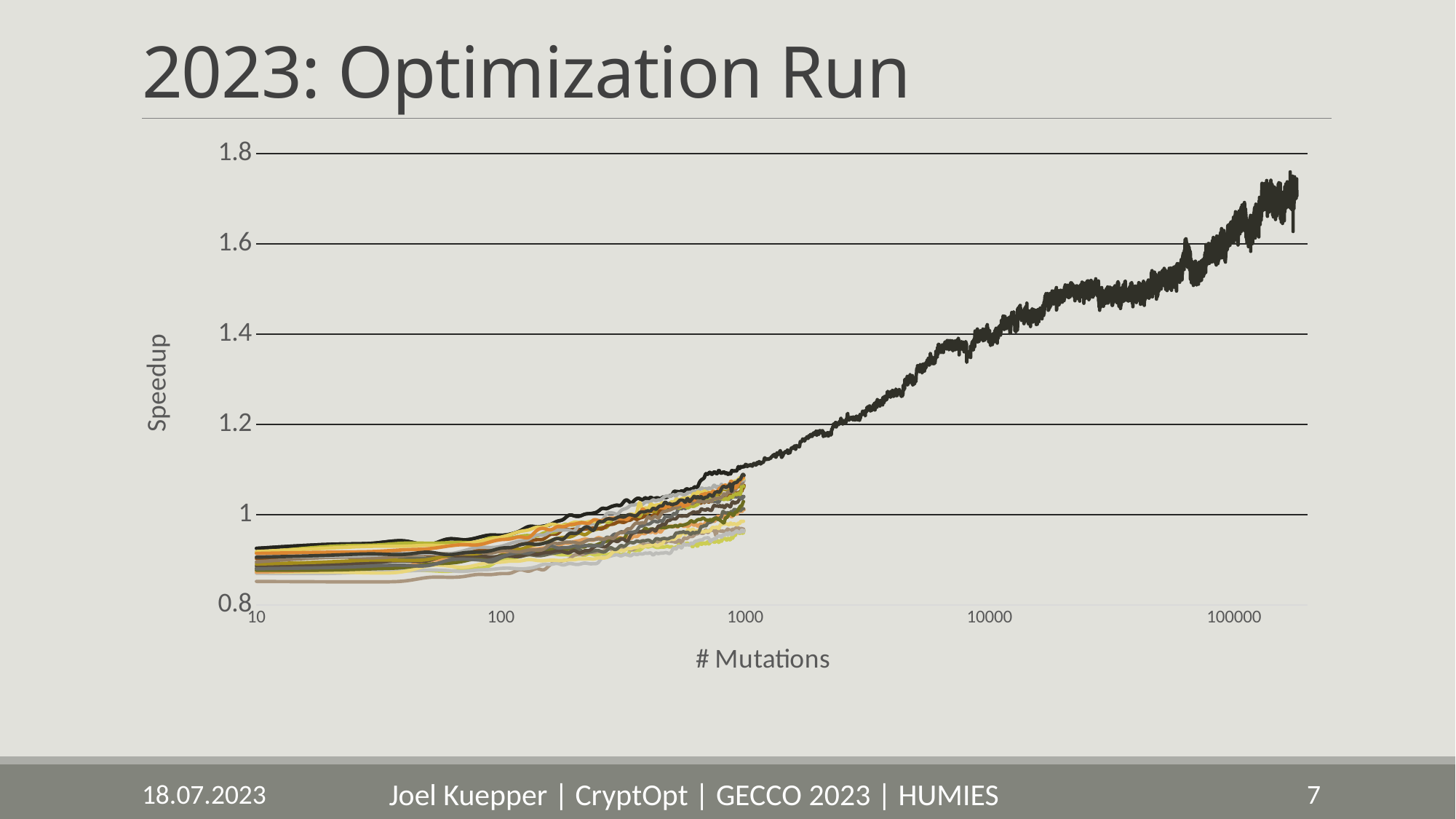
What is the label of the x axis? # Mutations At 1000 mutations, is the highest speedup value greater or less than 1.2? less What kind of chart is shown on the slide? line chart At 10000 mutations, is the speedup of the long dark line greater or less than 1.2? greater At 10 mutations, are the speedup values greater or less than 1? less Does the speedup generally rise or fall as the number of mutations increases? rise What is the label of the y axis? Speedup Is the speedup at the right end of the x axis greater or less than the speedup at the left end? greater